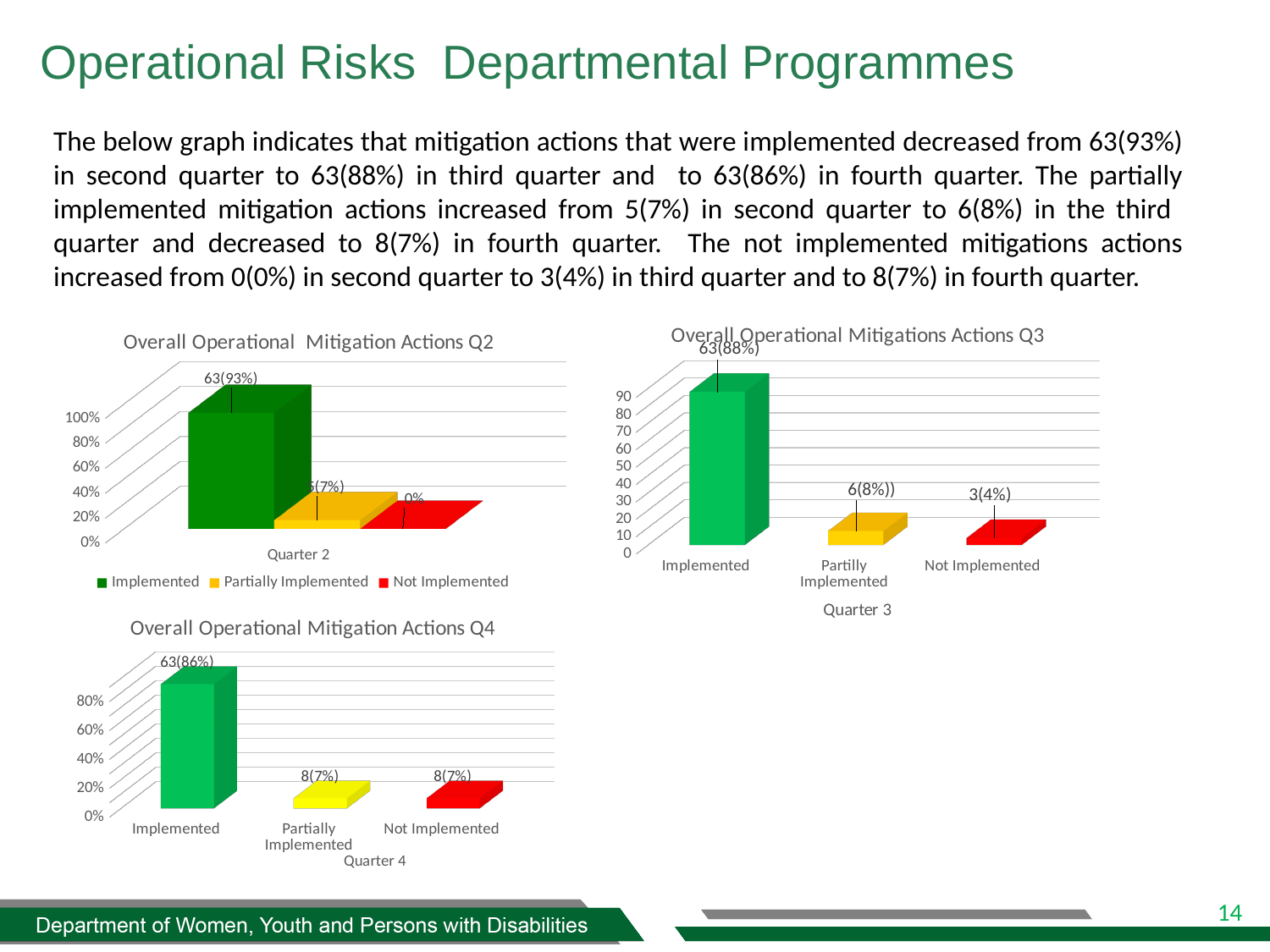
In the chart titled 'Overall Operational Mitigation Actions Q2', what is the data label on the Implemented bar? 63(93%) In the chart titled 'Overall Operational Mitigations Actions Q3', which category has the highest value? Implemented In the chart titled 'Overall Operational Mitigation Actions Q2', what is the data label on the Not Implemented bar? 0% In the chart titled 'Overall Operational Mitigations Actions Q3', what is the data label on the Not Implemented bar? 3(4%) How many series does the legend list in the chart titled 'Overall Operational Mitigation Actions Q2'? 3 In the chart titled 'Overall Operational Mitigations Actions Q3', which category has the lowest value? Not Implemented What kind of chart is the chart titled 'Overall Operational Mitigation Actions Q4'? Bar chart In the chart titled 'Overall Operational Mitigations Actions Q3', what is the data label on the Implemented bar? 63(88%) In the chart titled 'Overall Operational Mitigations Actions Q3', is the value for Not Implemented greater or less than 10? less In the chart titled 'Overall Operational Mitigation Actions Q4', is the value for Implemented greater or less than 60%? greater In the chart titled 'Overall Operational Mitigation Actions Q4', what is the data label on the Partially Implemented bar? 8(7%) In the chart titled 'Overall Operational Mitigation Actions Q4', what is the data label on the Implemented bar? 63(86%)